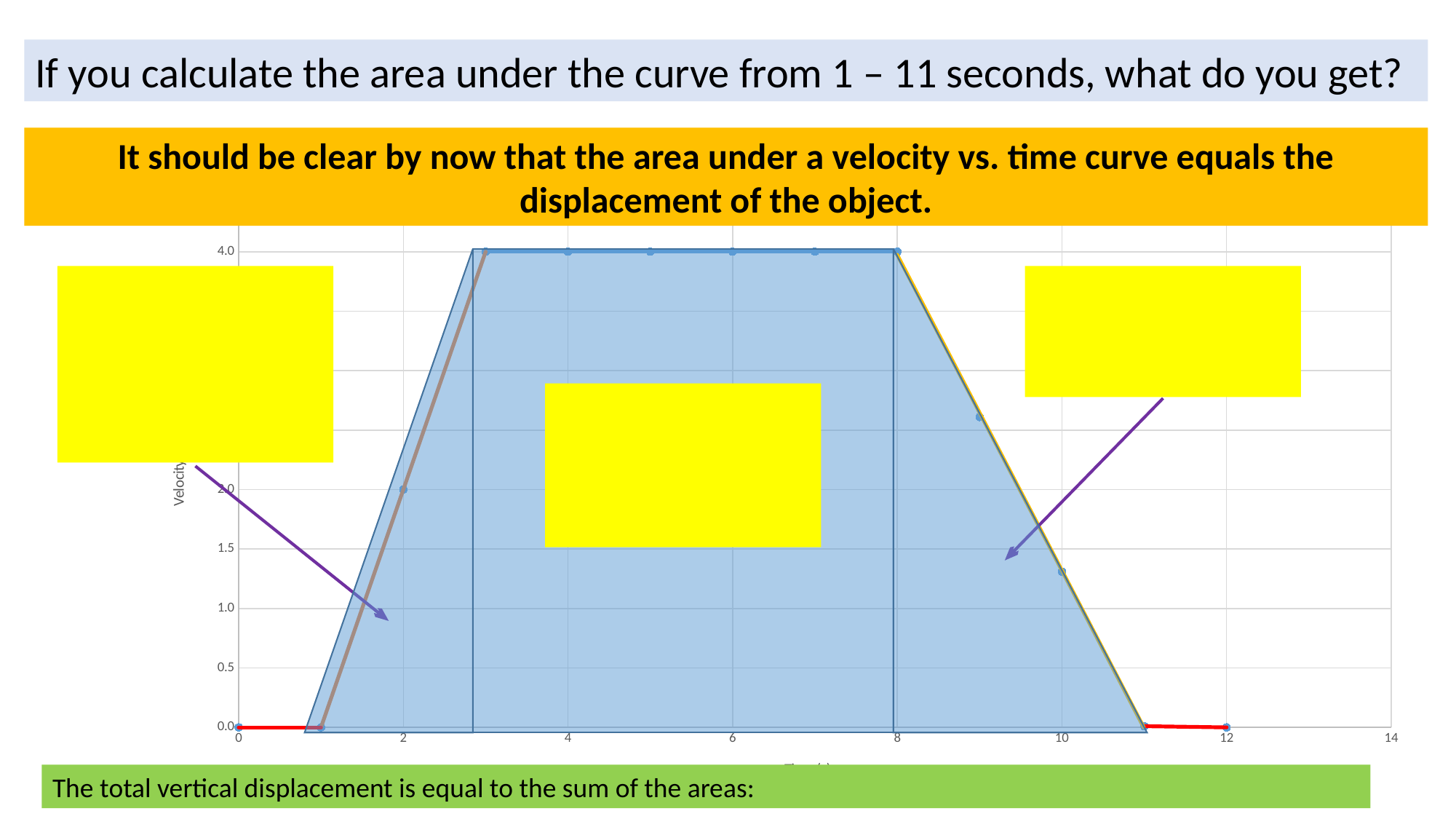
What is the velocity value plotted at time 4 on the x axis? 4.0 What kind of chart is shown on the slide? line chart Between time 8 and time 10, does the plotted line rise or fall? fall What is the velocity value plotted at time 6 on the x axis? 4.0 What is the velocity value plotted at time 12 on the x axis? 0.0 Is the value plotted at time 10 greater or less than 1.0? greater What is the label on the vertical axis of the chart? Velocity What is the largest tick value shown on the x axis? 14 What is the highest velocity value reached by the plotted line? 4.0 What is the velocity value plotted at time 0 on the x axis? 0.0 Is the value plotted at time 9 greater or less than 3.0? less Which is larger, the value plotted at time 6 or the value plotted at time 10? time 6